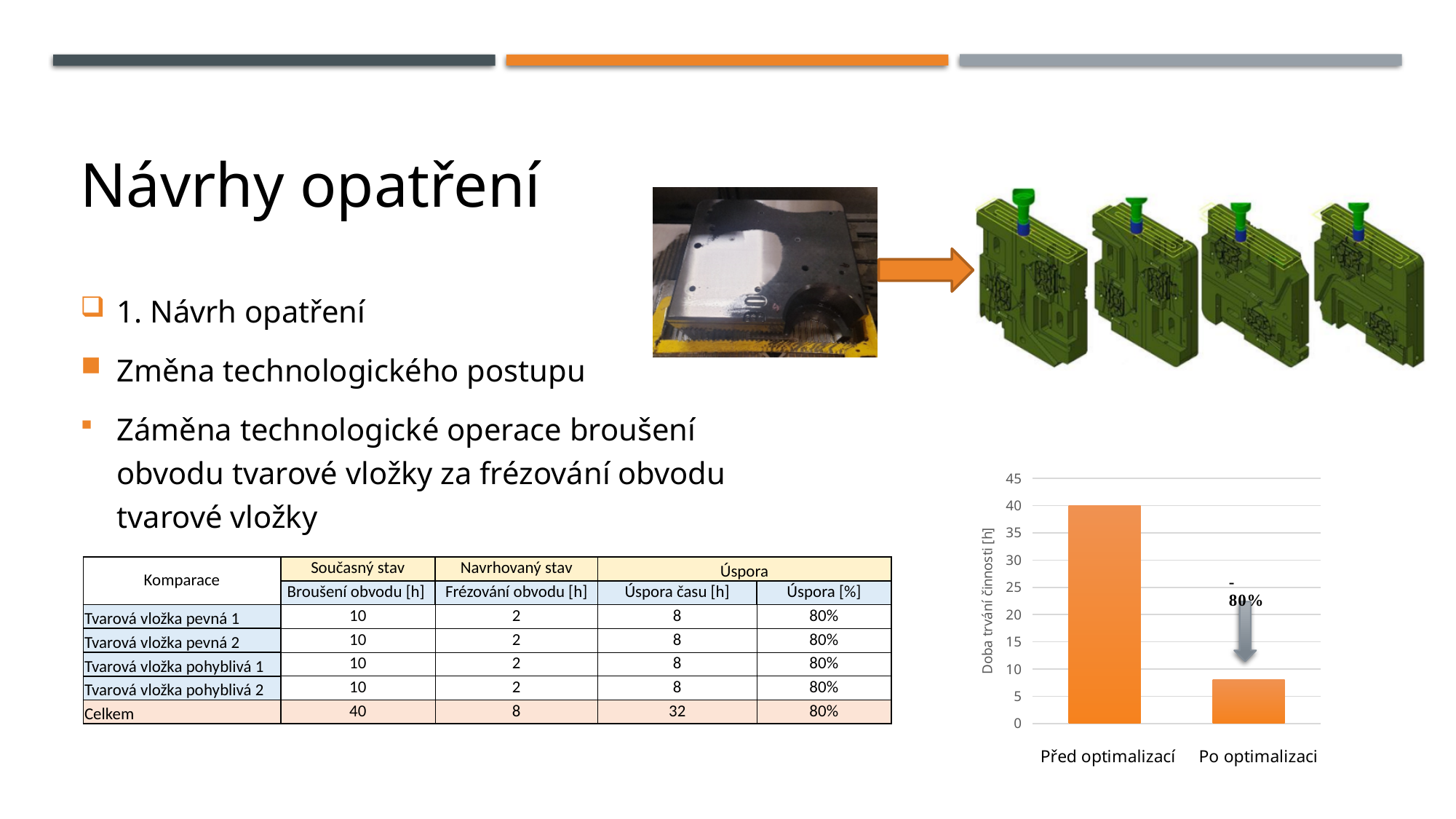
Which is larger, the bar for Před optimalizací or the bar for Po optimalizaci? Před optimalizací Is the value for Po optimalizaci greater or less than 10? less Is the value for Před optimalizací greater or less than 35? greater What percentage change is annotated above the Po optimalizaci bar? -80% What is the label of the y axis of the chart? Doba trvání činnosti [h] Is the value for Po optimalizaci greater or less than 5? greater How many bars does the chart on the right show? 2 Do the bar values rise or fall from left to right along the x axis? fall What kind of chart is shown on the right side of the slide? bar chart Which category has the lowest bar in the chart? Po optimalizaci Which category has the highest bar in the chart? Před optimalizací What value does the bar for Před optimalizací reach on the y axis? 40